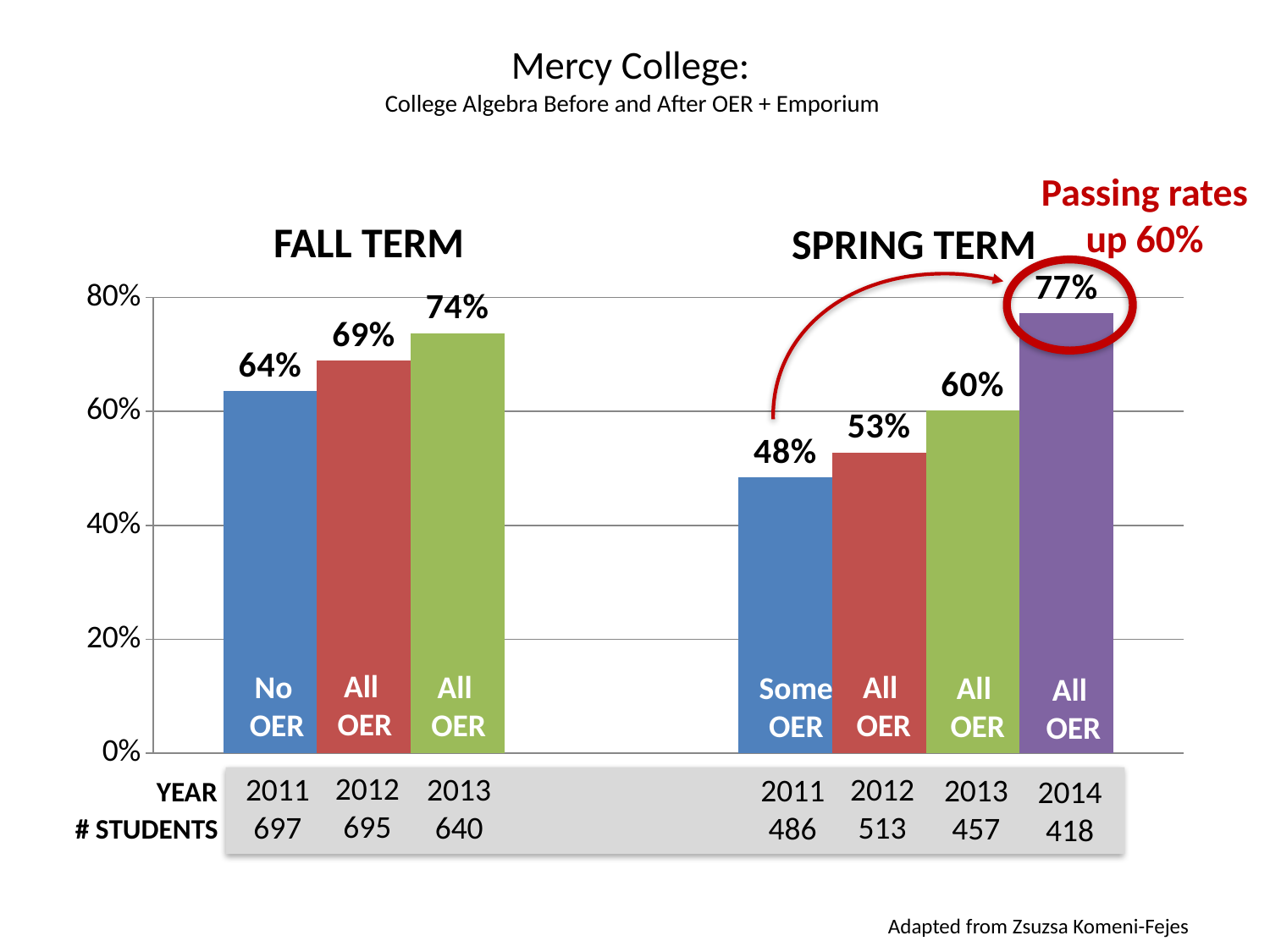
What is the passing rate for the Spring Term in 2012? 53% What kind of chart is shown on the slide? Bar chart Which year has the highest passing rate in the Fall Term? 2013 What is the difference between the Spring Term passing rates in 2014 and 2011? 29% Which year has the lowest passing rate in the Spring Term? 2011 What is the difference between the Fall Term passing rates in 2013 and 2011? 10% What is the passing rate for the Spring Term in 2014? 77% Do the Spring Term passing rates rise or fall from 2011 to 2014? Rise What is the passing rate for the Fall Term in 2011? 64% How many students were in the Fall Term 2011 course? 697 Which is larger, the Fall Term 2013 passing rate or the Spring Term 2013 passing rate? Fall Term 2013 How many bars are shown for the Spring Term? 4